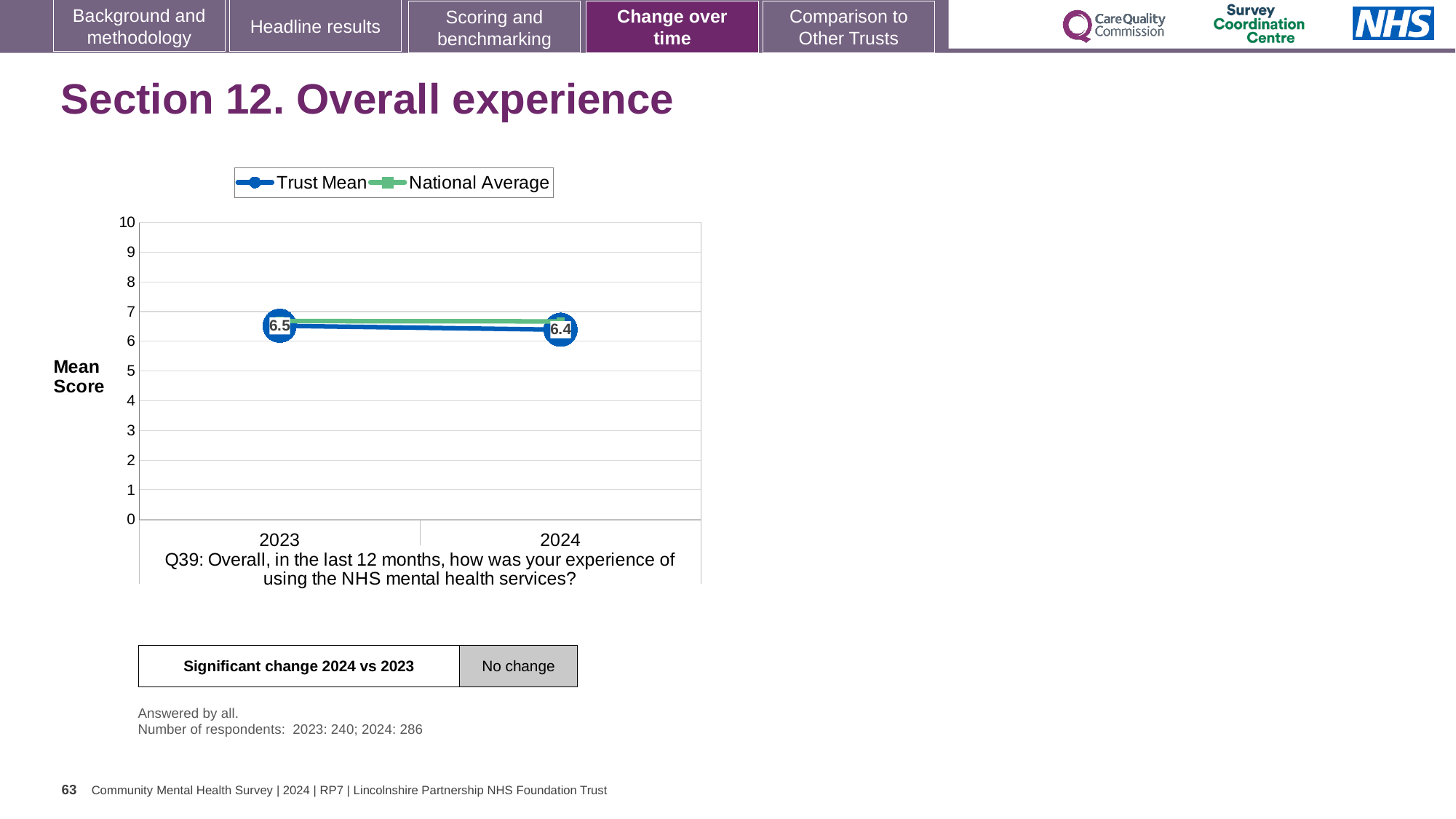
What is the Trust Mean score for 2023? 6.5 How many series does the chart legend list? 2 What is the Trust Mean score for 2024? 6.4 What kind of chart is shown on the slide? line chart Is the National Average value for 2023 greater or less than 6? greater What is the difference between the Trust Mean scores for 2023 and 2024? 0.1 In 2024, which is higher, the Trust Mean or the National Average? National Average In which year is the Trust Mean score higher, 2023 or 2024? 2023 What is the label of the y axis of the chart? Mean Score Is the National Average value for 2024 greater or less than 7? less Does the Trust Mean rise or fall from 2023 to 2024? fall How many years are plotted on the x axis of the chart? 2